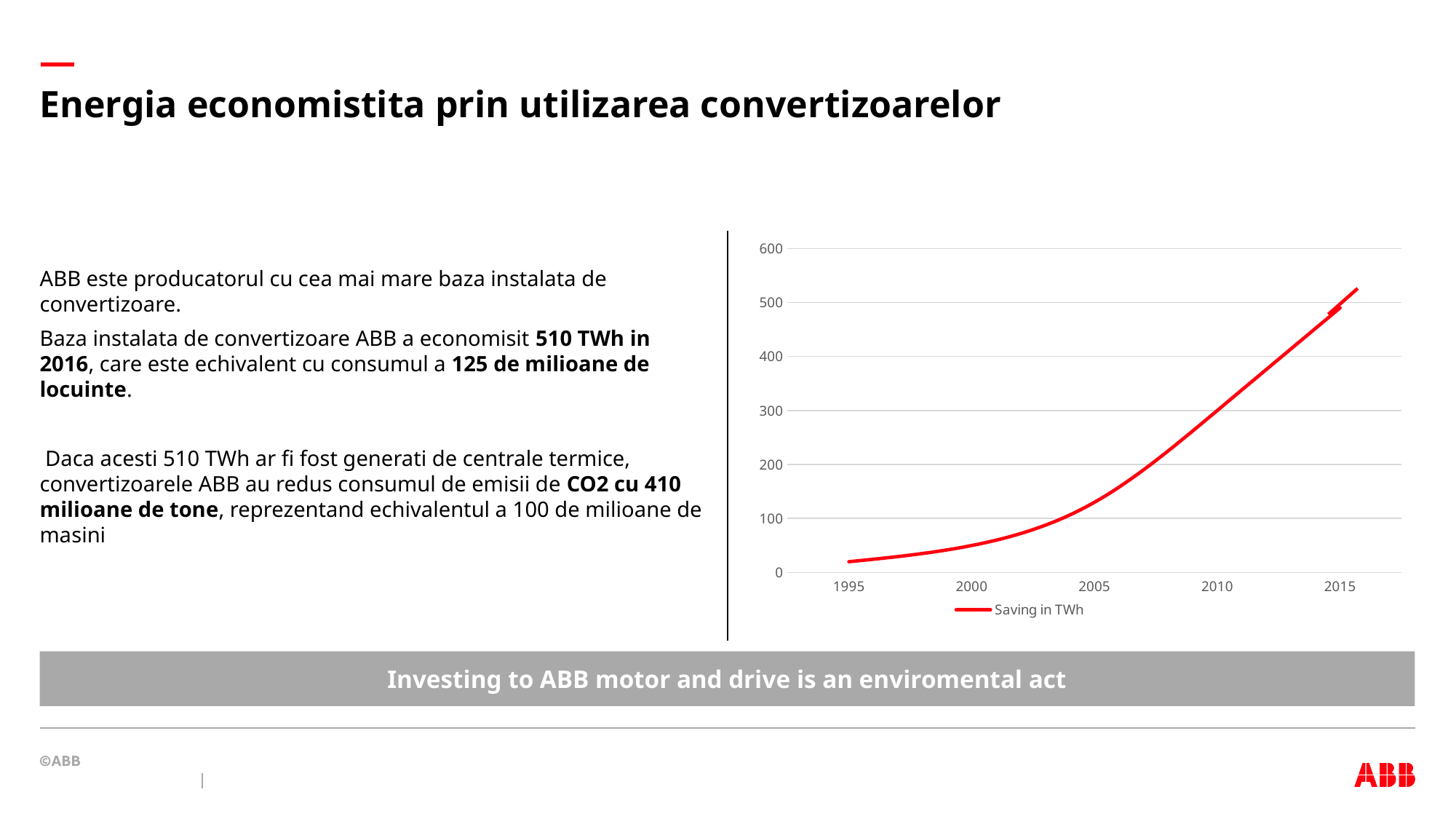
What is the highest value shown on the chart's vertical axis? 600 Is the value for Saving in TWh in 2005 greater or less than 300? less Is the value for Saving in TWh in 2000 greater or less than 100? less What kind of chart is shown on the slide? line chart Is the value for Saving in TWh in 2015 greater or less than 400? greater Do the values of the Saving in TWh line rise or fall from 1995 to 2015? rise What colour is the Saving in TWh line in the chart? red How many series does the chart legend list? 1 Which year shows a larger value for Saving in TWh, 2000 or 2010? 2010 What is the name of the series shown in the chart legend? Saving in TWh